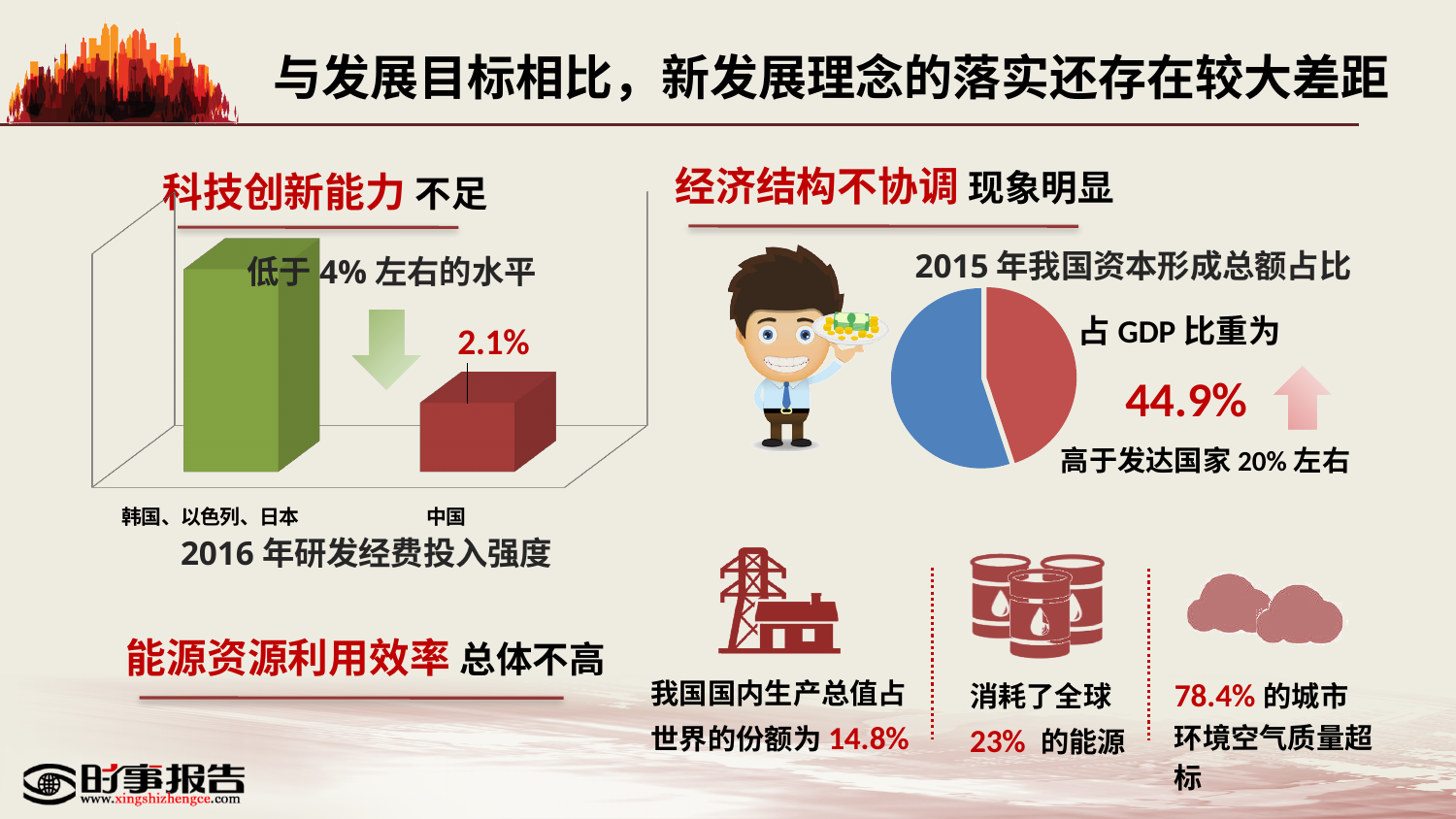
In the bar chart titled 2016年研发经费投入强度, which is larger, the bar for 韩国、以色列、日本 or the bar for 中国? 韩国、以色列、日本 In the bar chart titled 2016年研发经费投入强度, what is the value for 中国? 2.1% How many slices does the pie chart titled 2015年我国资本形成总额占比 have? 2 In the pie chart titled 2015年我国资本形成总额占比, which slice is larger, the blue one or the red one? blue What kind of chart is the chart titled 2016年研发经费投入强度? bar chart What is the title of the chart on the left side of the slide? 2016年研发经费投入强度 What kind of chart is the chart titled 2015年我国资本形成总额占比? pie chart In the bar chart titled 2016年研发经费投入强度, which category has the highest bar? 韩国、以色列、日本 What is the title of the pie chart on the right side of the slide? 2015年我国资本形成总额占比 In the pie chart titled 2015年我国资本形成总额占比, what share does the red slice represent? 44.9% In the bar chart titled 2016年研发经费投入强度, which category has the lowest bar? 中国 How many bars are shown in the bar chart titled 2016年研发经费投入强度? 2